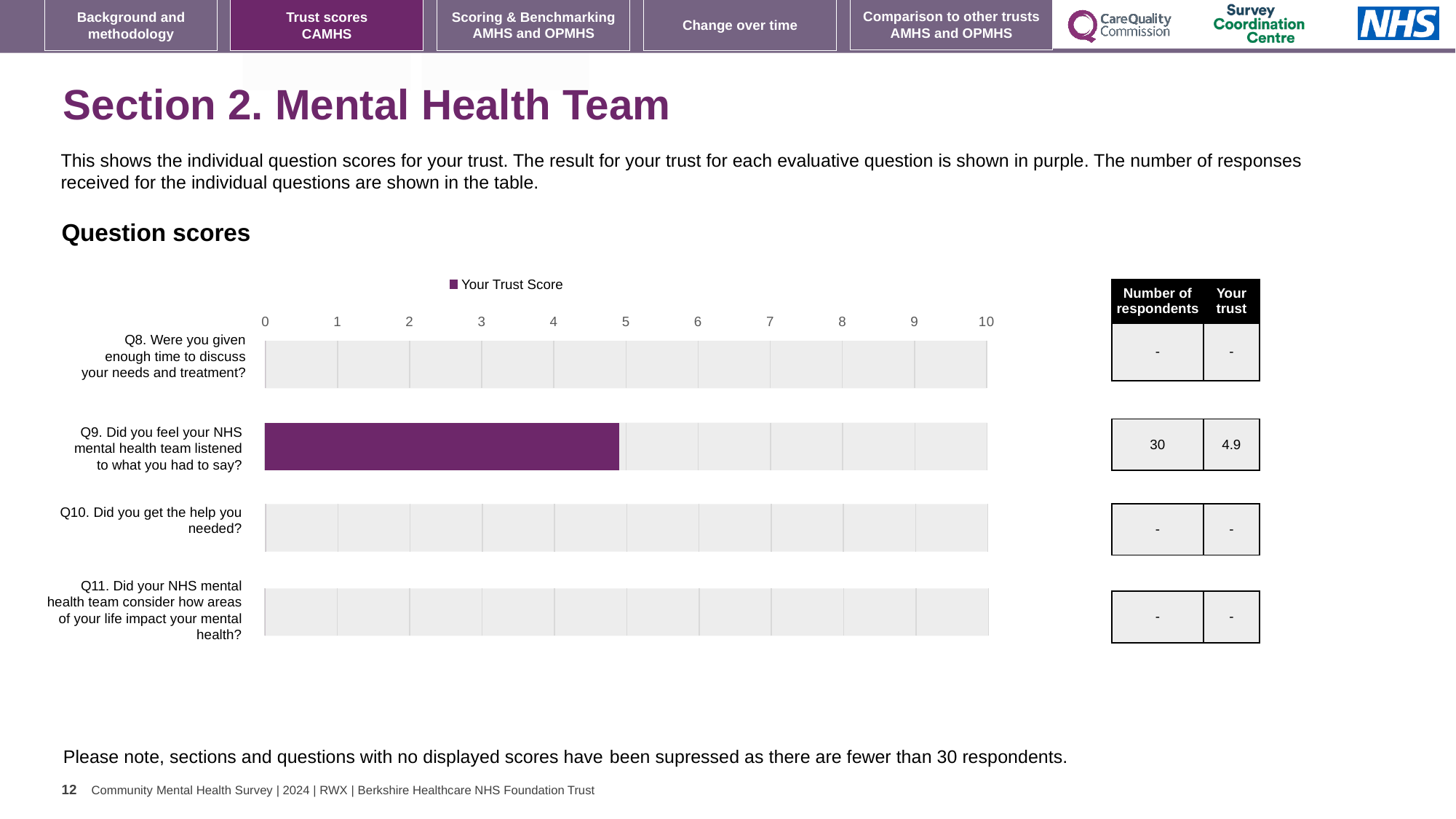
Is the value for Q9 greater or less than 4? greater How many respondents answered Q9? 30 What is the maximum value shown on the chart's x axis? 10 Is the value for Q9 greater or less than 6? less What is the name of the series shown in the chart legend? Your Trust Score How many questions on the chart have no displayed score (shown as '-')? 3 What kind of chart is shown under 'Question scores'? bar chart How many questions (categories) are listed on the chart? 4 What is the trust score for Q9 (Did you feel your NHS mental health team listened to what you had to say?)? 4.9 Which question has the highest displayed trust score on the chart? Q9 How many series does the chart legend list? 1